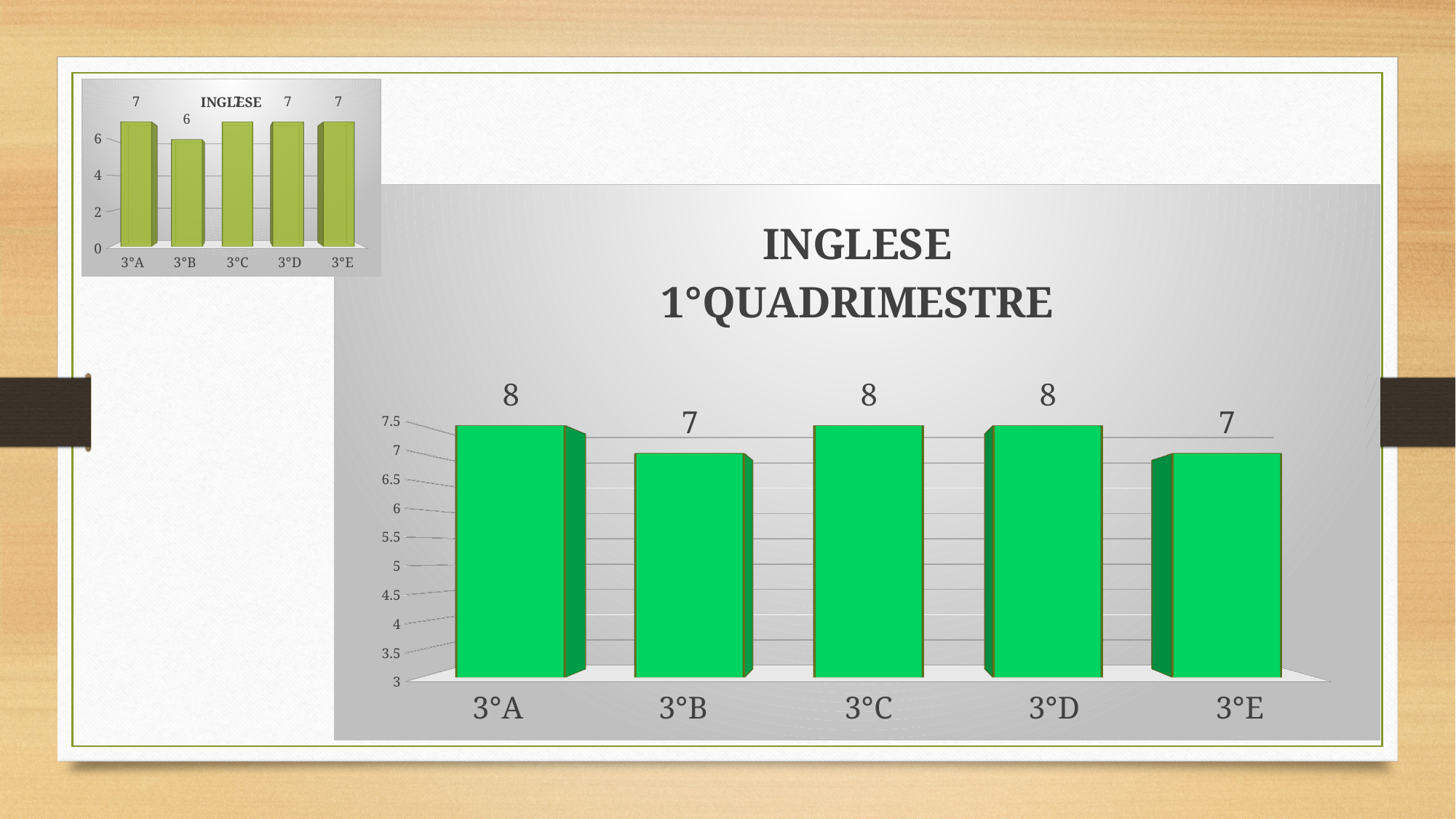
In the small chart at the top left titled INGLESE, what is the value for 3°A? 7 In the large chart titled INGLESE 1°QUADRIMESTRE, which category has the lowest value, 3°B or 3°C? 3°B In the large chart titled INGLESE 1°QUADRIMESTRE, how many categories are shown on the x axis? 5 What is the title of the large chart on the slide? INGLESE 1°QUADRIMESTRE In the large chart titled INGLESE 1°QUADRIMESTRE, what is the value for 3°E? 7 In the small chart at the top left titled INGLESE, which category has the lowest value? 3°B In the large chart titled INGLESE 1°QUADRIMESTRE, what is the value for 3°A? 8 In the small chart at the top left titled INGLESE, what is the difference between the values for 3°E and 3°B? 1 In the large chart titled INGLESE 1°QUADRIMESTRE, what is the value for 3°B? 7 In the small chart at the top left titled INGLESE, what is the value for 3°B? 6 What kind of chart is the large chart titled INGLESE 1°QUADRIMESTRE? bar chart In the large chart titled INGLESE 1°QUADRIMESTRE, what is the difference between the values for 3°C and 3°E? 1